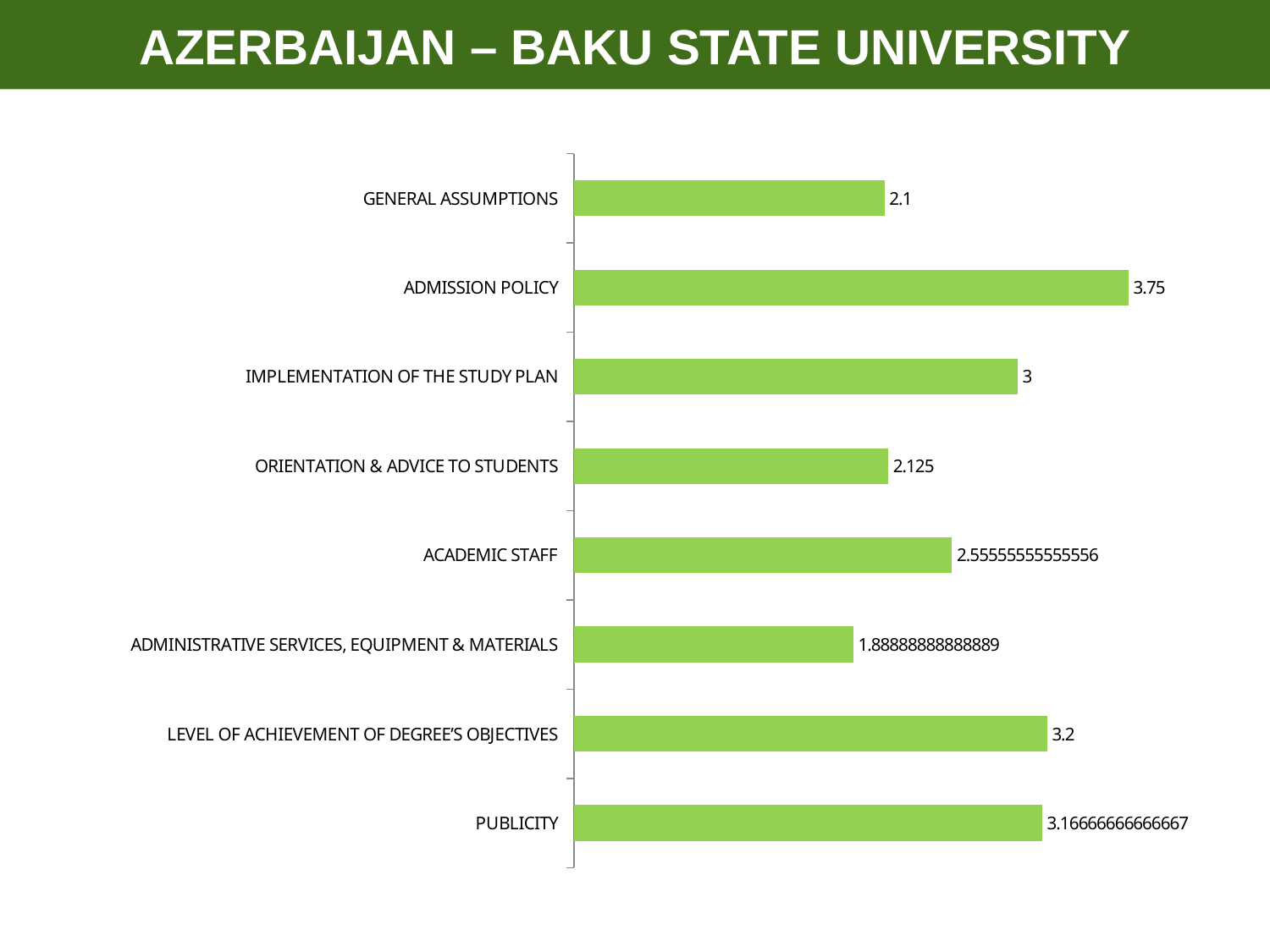
How many categories are shown in the chart? 8 What is the value for ACADEMIC STAFF? 2.55555555555556 What is the value for ADMINISTRATIVE SERVICES, EQUIPMENT & MATERIALS? 1.88888888888889 What is the difference between the values for ADMISSION POLICY and IMPLEMENTATION OF THE STUDY PLAN? 0.75 Which is larger, the value for IMPLEMENTATION OF THE STUDY PLAN or the value for ACADEMIC STAFF? IMPLEMENTATION OF THE STUDY PLAN What is the value for ADMISSION POLICY? 3.75 What is the value for GENERAL ASSUMPTIONS? 2.1 Which category has the highest value? ADMISSION POLICY What is the value for PUBLICITY? 3.16666666666667 What is the difference between the values for LEVEL OF ACHIEVEMENT OF DEGREE'S OBJECTIVES and GENERAL ASSUMPTIONS? 1.1 Which category has the lowest value? ADMINISTRATIVE SERVICES, EQUIPMENT & MATERIALS What kind of chart is shown on the slide? Bar chart